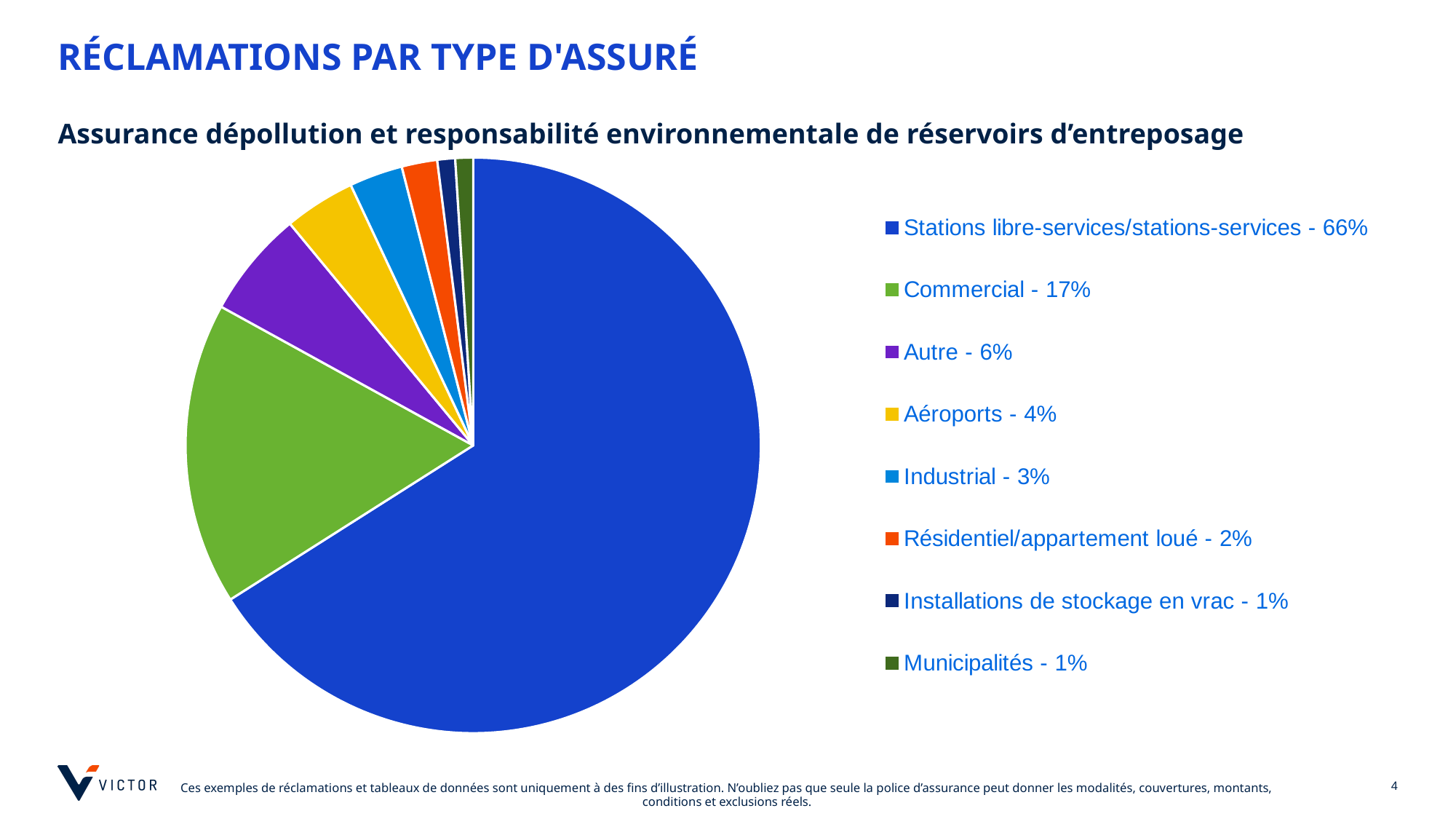
What colour is the slice for Aéroports? Yellow What share of claims is attributed to Aéroports? 4% What kind of chart is shown on the slide? Pie chart Which is larger, the share for Autre or the share for Industrial? Autre Which two categories share the smallest value of 1%? Installations de stockage en vrac and Municipalités What is the difference in percentage points between Stations libre-services/stations-services and Commercial? 49 What share of claims is attributed to Commercial? 17% How many categories does the legend list? 8 What is the difference in percentage points between Autre and Aéroports? 2 What is the share of the largest slice? 66% Which category has the largest share of claims? Stations libre-services/stations-services What share of claims is attributed to Résidentiel/appartement loué? 2%